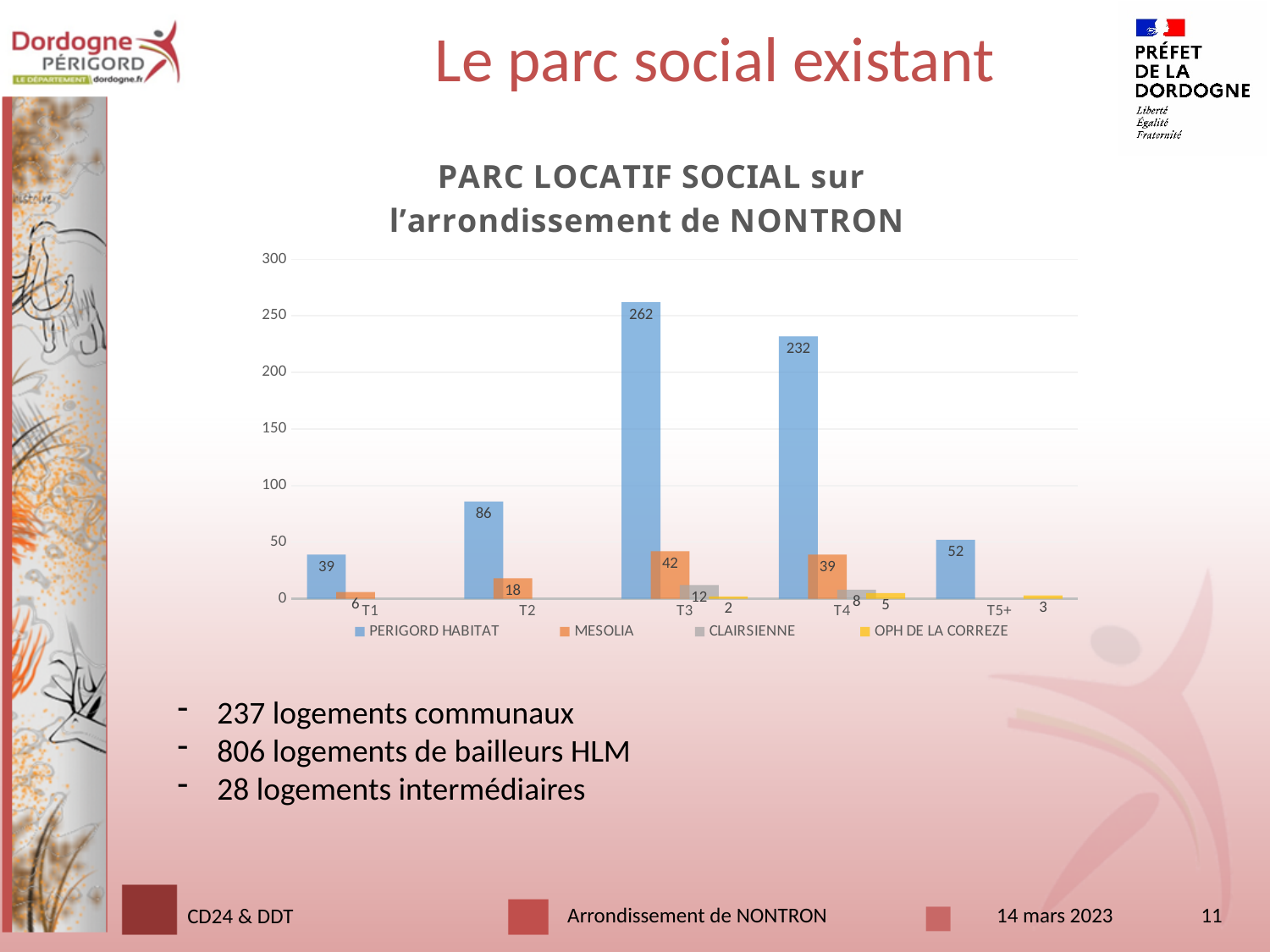
What is the difference between the PERIGORD HABITAT values for T3 and T4? 30 How many categories are shown on the x axis? 5 What is the value for PERIGORD HABITAT in category T3? 262 What type of chart is shown on the slide? bar chart Which category has the lowest value for PERIGORD HABITAT? T1 Which category has the highest value for PERIGORD HABITAT? T3 Is the value for PERIGORD HABITAT in T4 greater or less than 200? greater How many series does the legend list? 4 What is the value for PERIGORD HABITAT in category T2? 86 What is the title of the chart? PARC LOCATIF SOCIAL sur l'arrondissement de NONTRON What is the value for MESOLIA in category T4? 39 Which is larger: the MESOLIA value for T3 or the MESOLIA value for T2? T3